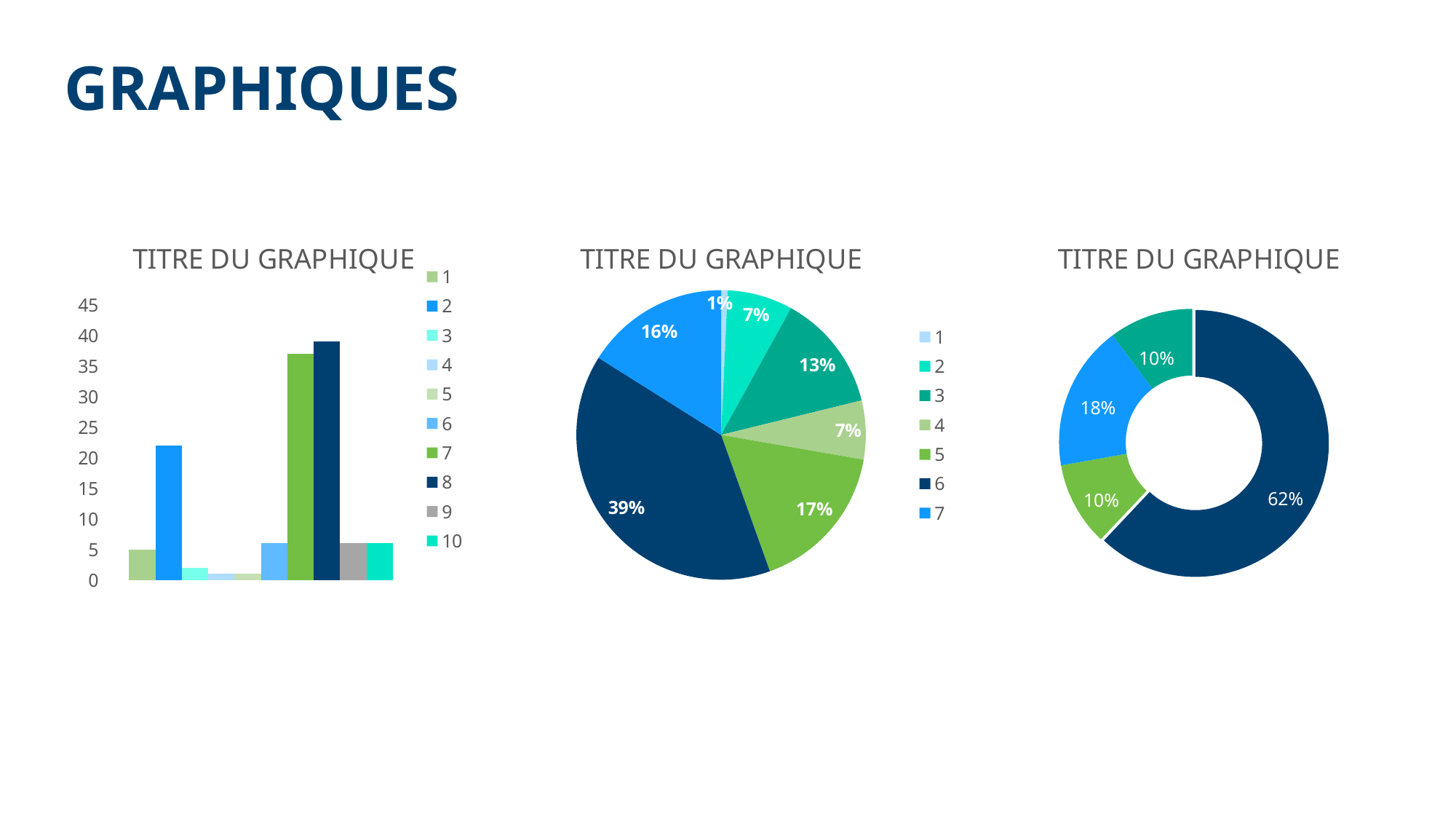
In the middle pie chart, which slice is the smallest? 1 What kind of chart is the left chart on the slide? bar chart In the left bar chart, which is larger, the value for series 2 or the value for series 7? series 7 In the left bar chart, is the value for series 1 greater or less than 10? less In the middle pie chart, what share does slice 6 have? 39% In the middle pie chart, what is the difference between the shares of slice 5 and slice 7? 1% In the left bar chart, is the value for series 2 greater or less than 20? greater In the right doughnut chart, what is the share of the largest slice? 62% How many series does the legend of the left bar chart list? 10 What kind of chart is the middle chart on the slide? pie chart In the left bar chart, is the value for series 7 greater or less than 35? greater In the middle pie chart, what share does slice 3 have? 13%